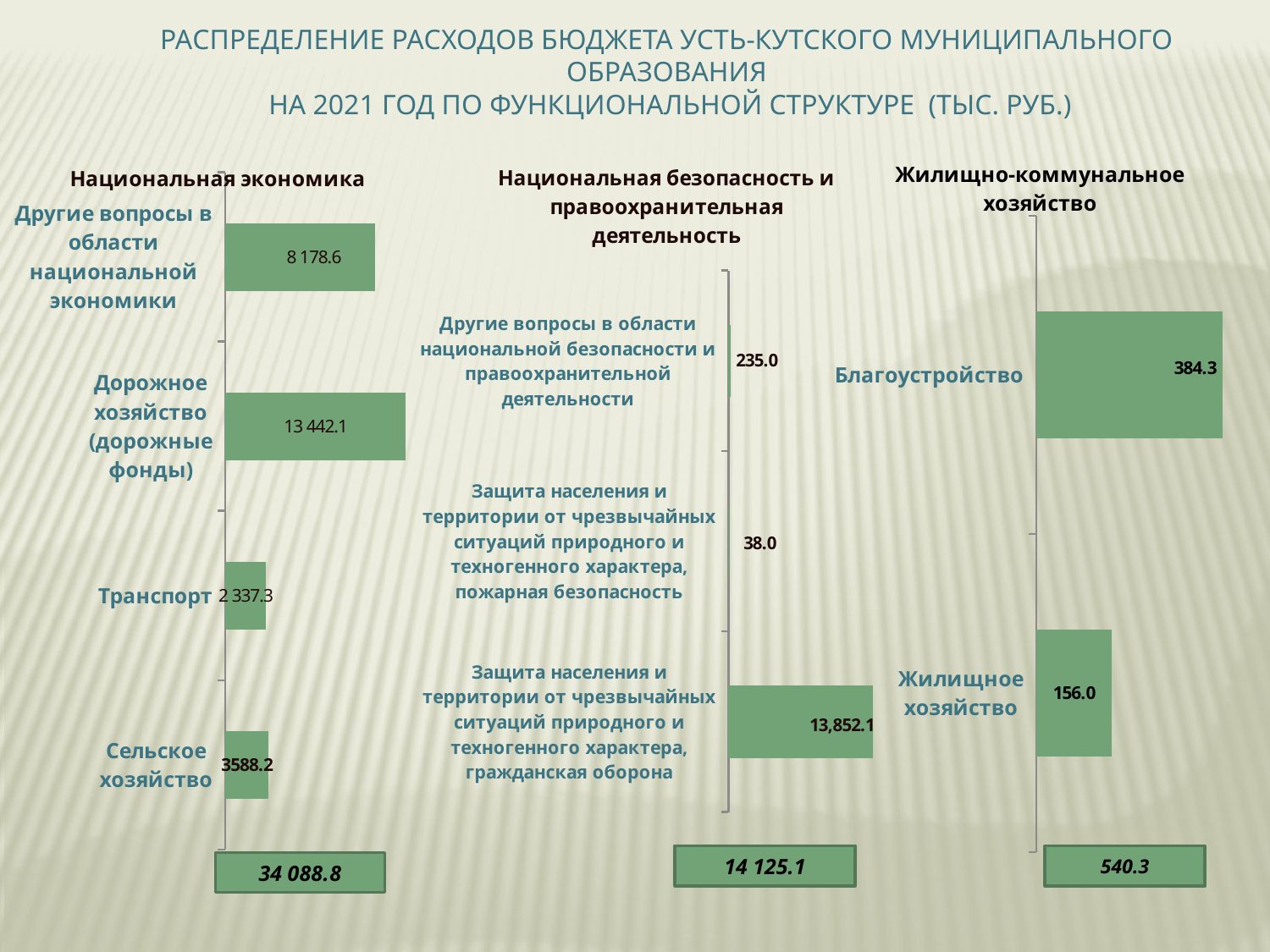
In the 'Национальная экономика' chart, which category has the highest value? Дорожное хозяйство (дорожные фонды) What kind of chart is the 'Жилищно-коммунальное хозяйство' chart? Bar chart In the 'Национальная безопасность и правоохранительная деятельность' chart, what is the value for 'Защита населения и территории от чрезвычайных ситуаций природного и техногенного характера, гражданская оборона'? 13,852.1 In the 'Жилищно-коммунальное хозяйство' chart, what is the value for 'Благоустройство'? 384.3 In the 'Жилищно-коммунальное хозяйство' chart, what is the difference between 'Благоустройство' and 'Жилищное хозяйство'? 228.3 In the 'Национальная экономика' chart, what is the value for 'Дорожное хозяйство (дорожные фонды)'? 13 442.1 In the 'Национальная безопасность и правоохранительная деятельность' chart, which category has the lowest value? Защита населения и территории от чрезвычайных ситуаций природного и техногенного характера, пожарная безопасность In the 'Жилищно-коммунальное хозяйство' chart, which is larger: 'Благоустройство' or 'Жилищное хозяйство'? Благоустройство In the 'Национальная экономика' chart, what is the value for 'Сельское хозяйство'? 3588.2 In the 'Национальная экономика' chart, which category has the lowest value? Транспорт In the 'Национальная безопасность и правоохранительная деятельность' chart, what is the difference between the value for 'Другие вопросы в области национальной безопасности и правоохранительной деятельности' and the value for 'Защита населения и территории от чрезвычайных ситуаций природного и техногенного характера, пожарная безопасность'? 197.0 In the 'Национальная экономика' chart, how many categories are shown? 4